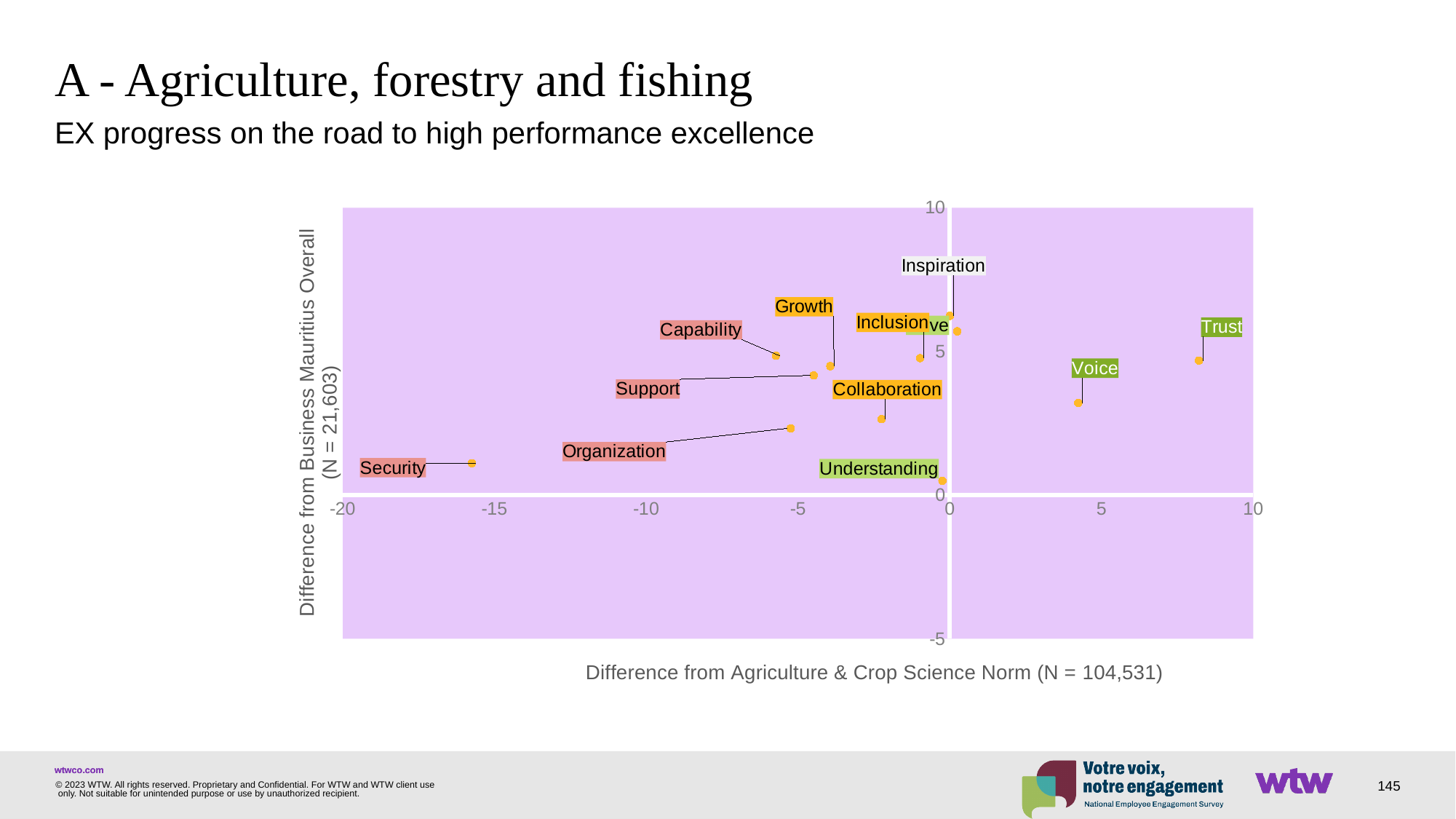
Which has the larger horizontal-axis value, Security or Organization? Organization Which labeled point has the lowest value on the horizontal axis (Difference from Agriculture & Crop Science Norm)? Security Which has the larger horizontal-axis value, Trust or Voice? Trust What is the title of the horizontal axis? Difference from Agriculture & Crop Science Norm (N = 104,531) Is the vertical-axis value for Understanding greater or less than 5? less Is the horizontal-axis value for Voice greater or less than 0? greater Is the vertical-axis value for Inspiration greater or less than 5? greater Which labeled point has the highest value on the horizontal axis (Difference from Agriculture & Crop Science Norm)? Trust What kind of chart is shown on the slide? scatter chart What is the title of the vertical axis? Difference from Business Mauritius Overall (N = 21,603)